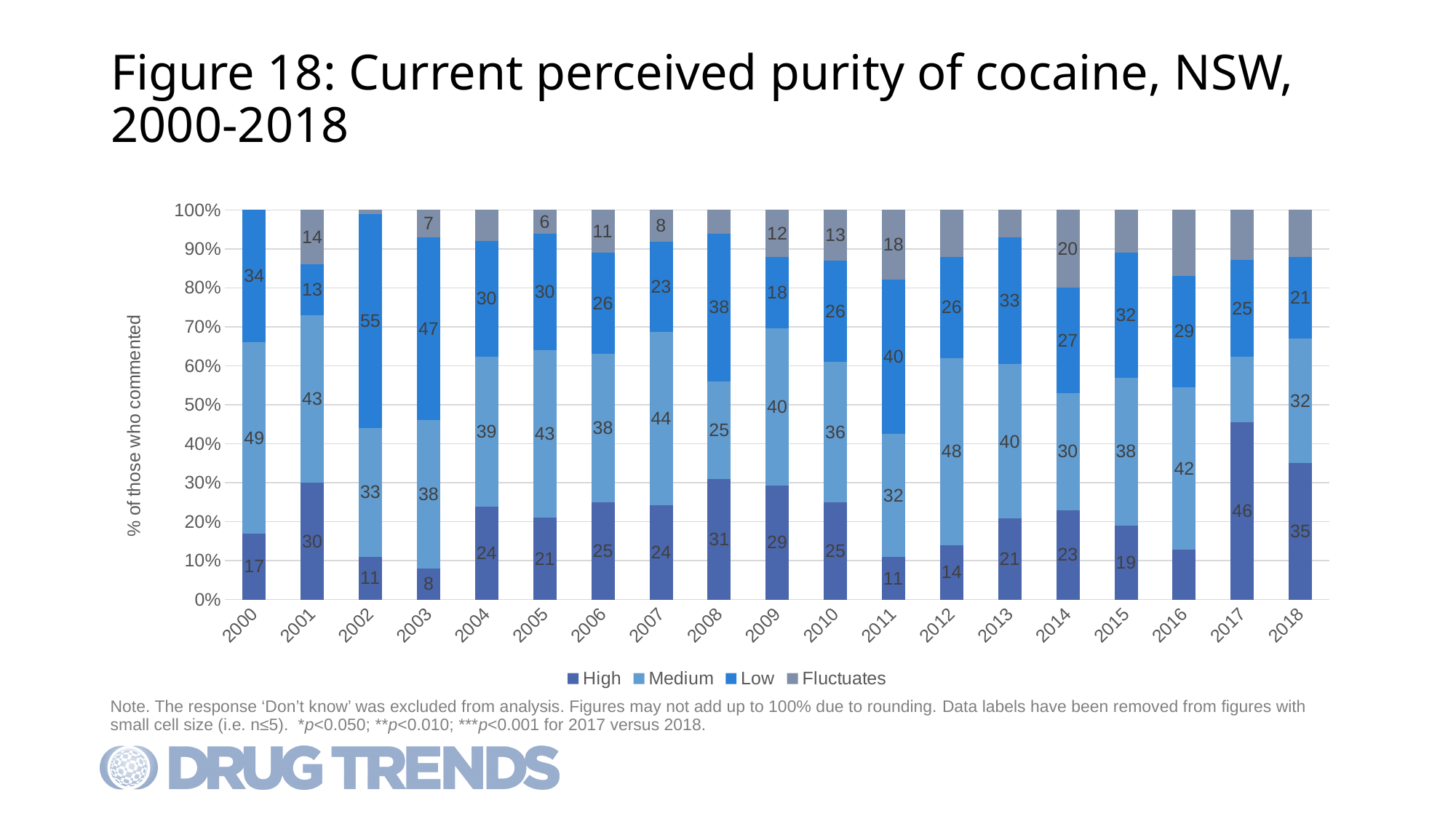
How many series does the legend list? 4 What is the value for High in 2017? 46 What is the label on the y axis? % of those who commented Which year has the highest value for High? 2017 What is the value for Fluctuates in 2014? 20 What is the value for Low in 2002? 55 Which year has the lowest labelled value for High? 2003 What is the difference between the High values for 2018 and 2017? 11 What type of chart is shown on the slide? Stacked bar chart What is the value for Medium in 2012? 48 Which is larger, the Low value in 2011 or the Low value in 2010? 2011 How many years are shown on the x axis? 19